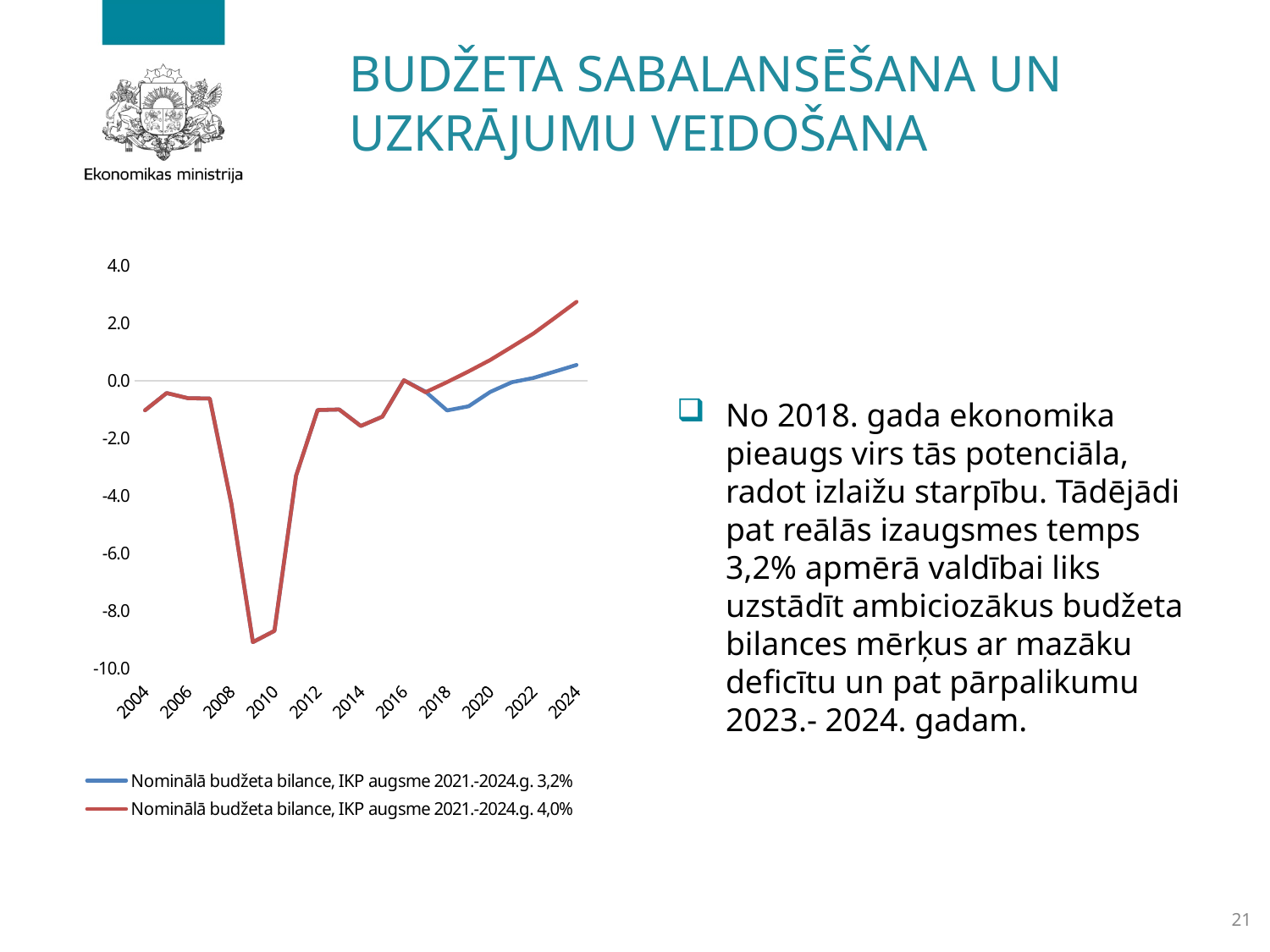
Is the value for 2004 greater or less than 0.0? less Between 2008 and 2010, does the line rise or fall? fall Is the value for 2014 greater or less than 0.0? less Which series has the higher value in 2024, the 3,2% series or the 4,0% series? Nominālā budžeta bilance, IKP augsme 2021.-2024.g. 4,0% What kind of chart is shown on the slide? line chart Is the value of the 'Nominālā budžeta bilance, IKP augsme 2021.-2024.g. 3,2%' series in 2024 greater or less than 0.0? greater What is the last year shown on the x axis? 2024 What is the first year shown on the x axis? 2004 How many series does the legend list? 2 Between 2018 and 2024, does the 'Nominālā budžeta bilance, IKP augsme 2021.-2024.g. 4,0%' series rise or fall? rise